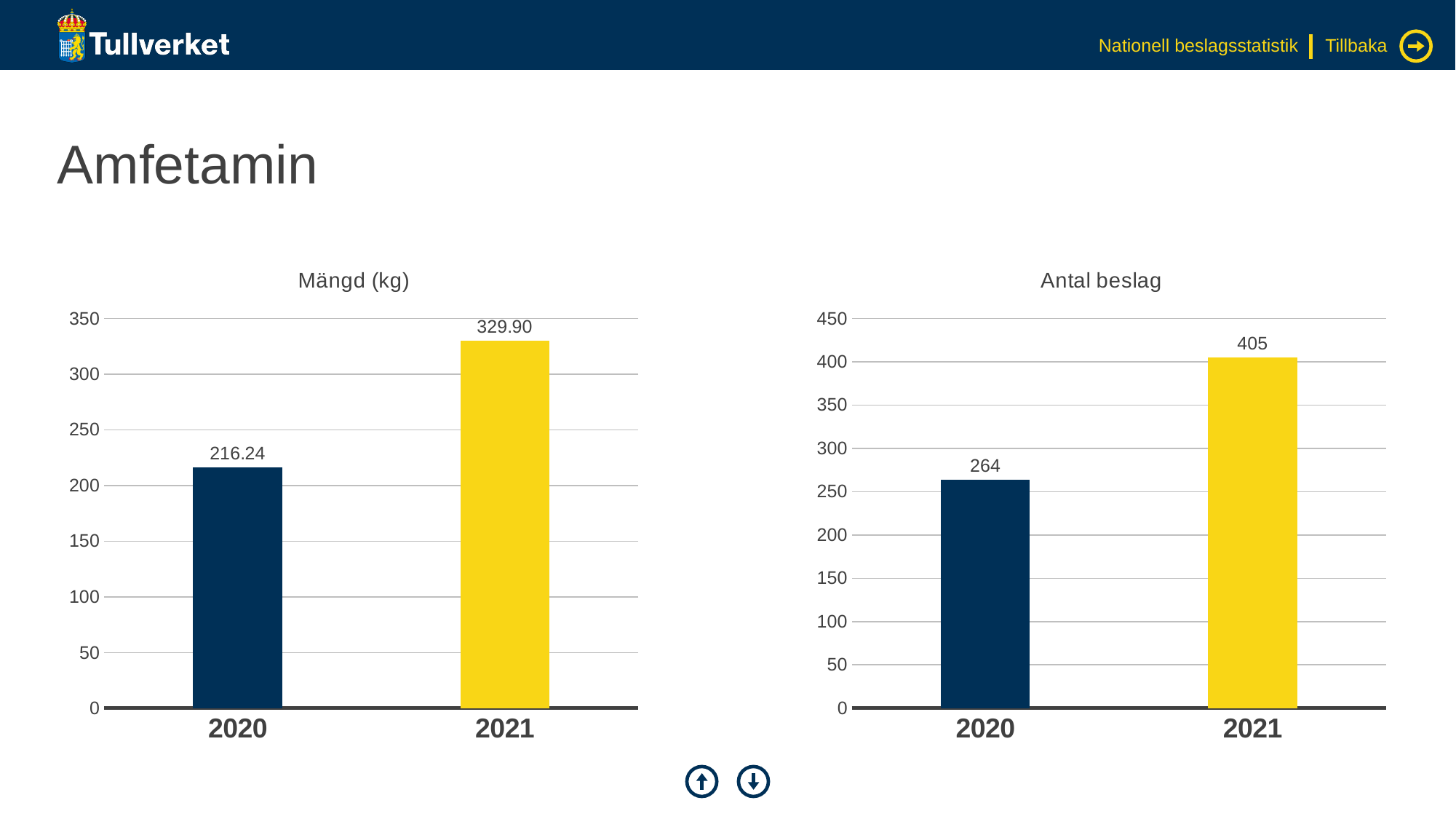
In the 'Antal beslag' chart, which year has the lowest value? 2020 What kind of chart is the 'Antal beslag' chart? bar chart How many categories are shown on the x axis of the 'Mängd (kg)' chart? 2 In the 'Antal beslag' chart, what is the value for 2020? 264 In the 'Mängd (kg)' chart, what is the value for 2021? 329.90 In the 'Antal beslag' chart, is the value for 2020 greater or less than 300? less In the 'Mängd (kg)' chart, what is the difference between the 2021 and 2020 values? 113.66 In the 'Antal beslag' chart, what is the value for 2021? 405 In the 'Antal beslag' chart, what is the difference between the 2021 and 2020 values? 141 In the 'Mängd (kg)' chart, which year has the highest value? 2021 In the 'Mängd (kg)' chart, do the values rise or fall from 2020 to 2021? rise In the 'Mängd (kg)' chart, what is the value for 2020? 216.24